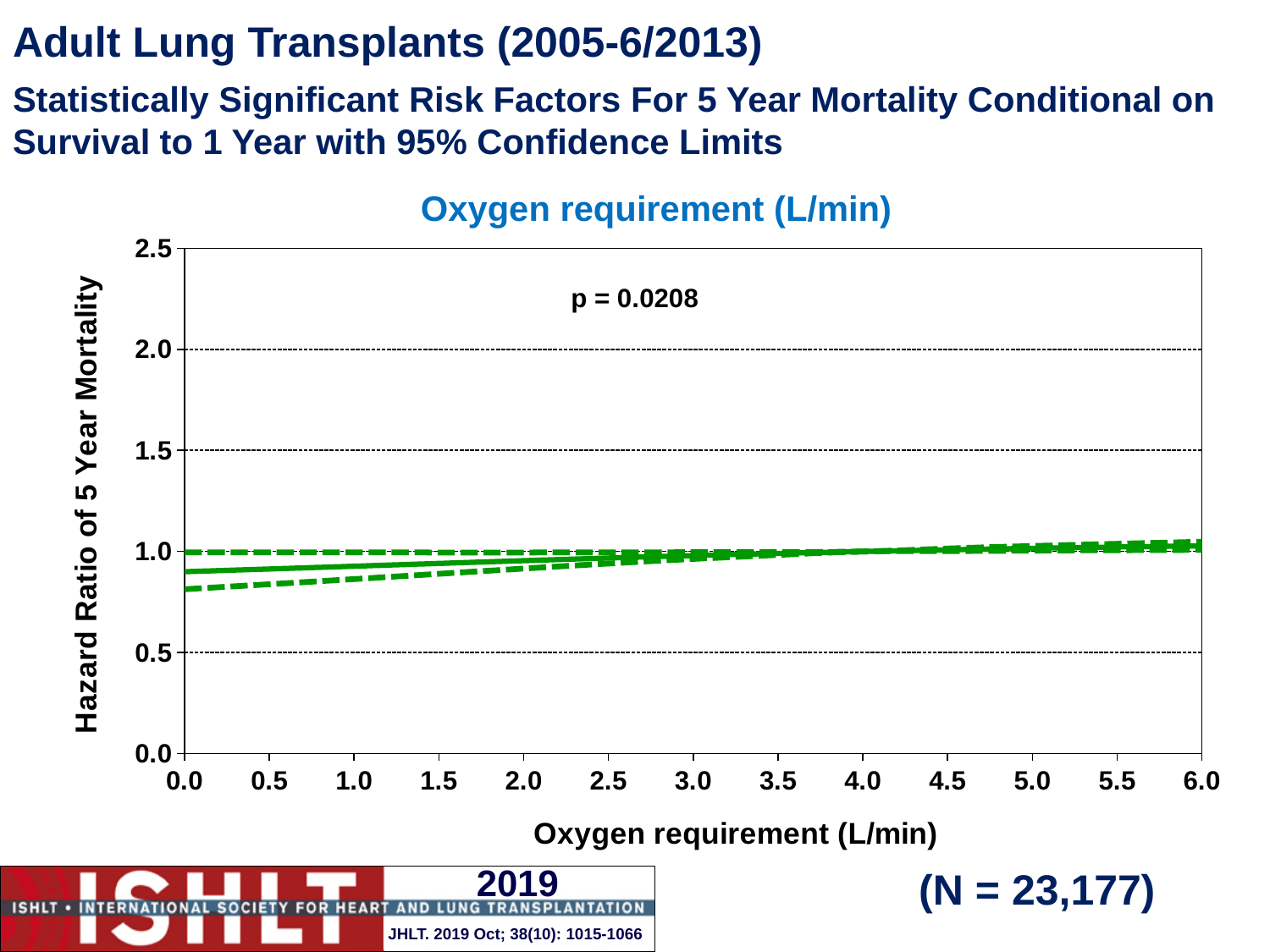
Does the solid hazard ratio line rise or fall as oxygen requirement increases from 0.0 to 6.0 L/min? rise What is the p-value printed on the chart? p = 0.0208 What is the sample size (N) shown on the slide? N = 23,177 Is the hazard ratio on the solid line at an oxygen requirement of 6.0 L/min greater or less than 1.5? less Is the upper dashed confidence limit at an oxygen requirement of 6.0 L/min greater or less than 0.5? greater What is the maximum oxygen requirement value shown on the x-axis? 6.0 Is the hazard ratio on the solid line at an oxygen requirement of 0.0 L/min greater or less than 1.0? less What kind of chart is shown on the slide? line chart How many lines are plotted on the chart? 3